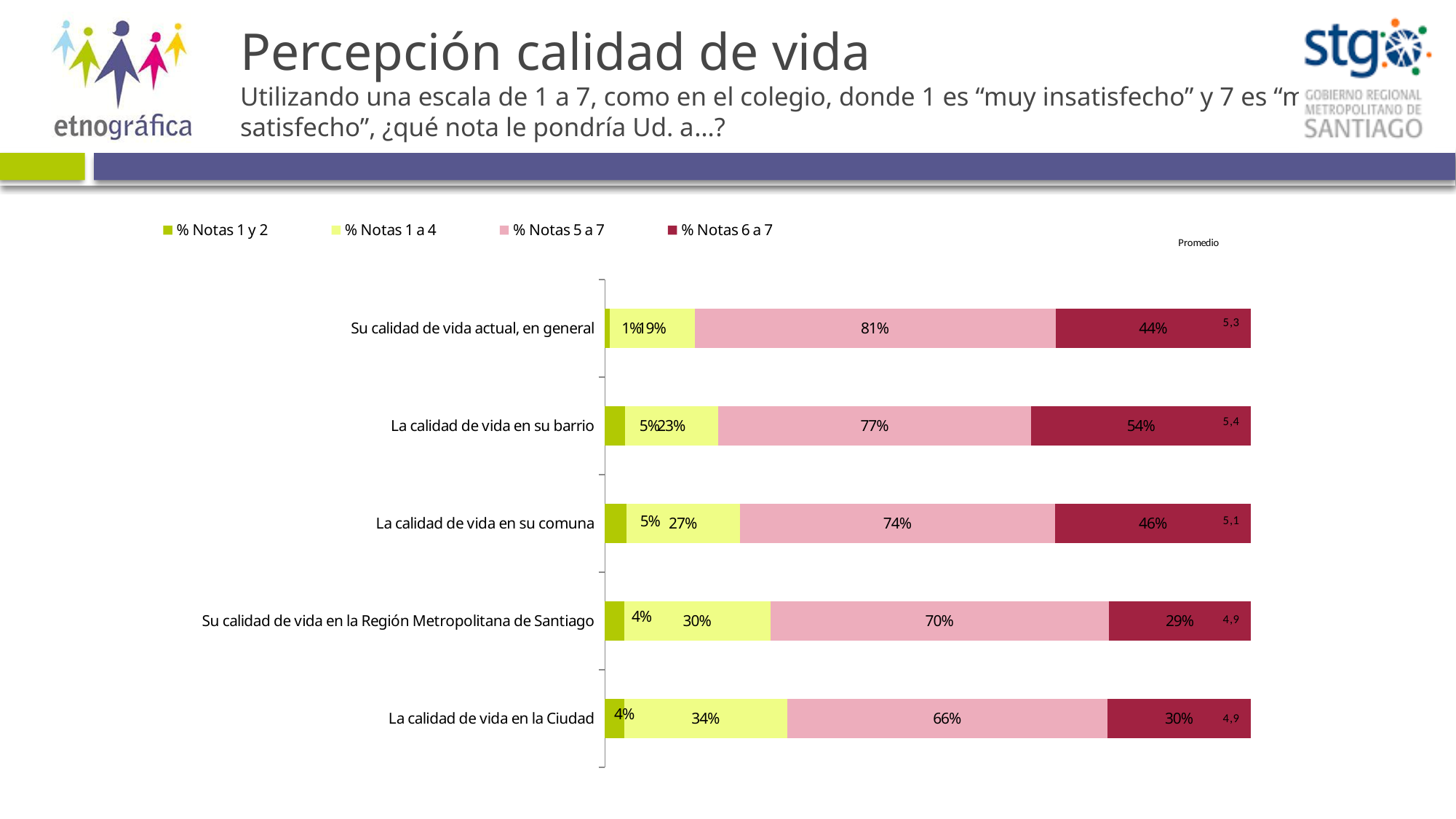
What kind of chart is shown on the slide? Stacked bar chart What is the % Notas 1 a 4 value for 'La calidad de vida en la Ciudad'? 34% What is the Promedio shown for 'La calidad de vida en su comuna'? 5,1 Which category has the lowest % Notas 5 a 7 value? La calidad de vida en la Ciudad What is the difference between the % Notas 5 a 7 values for 'Su calidad de vida actual, en general' and 'Su calidad de vida en la Región Metropolitana de Santiago'? 11% What is the % Notas 6 a 7 value for 'La calidad de vida en su barrio'? 54% Which legend entry is shown in dark red? % Notas 6 a 7 Which category has the highest % Notas 6 a 7 value? La calidad de vida en su barrio Which is larger: the % Notas 6 a 7 value for 'La calidad de vida en su comuna' or for 'La calidad de vida en la Ciudad'? La calidad de vida en su comuna How many series does the legend list? 4 How many categories are plotted in the chart? 5 What is the % Notas 5 a 7 value for 'Su calidad de vida actual, en general'? 81%